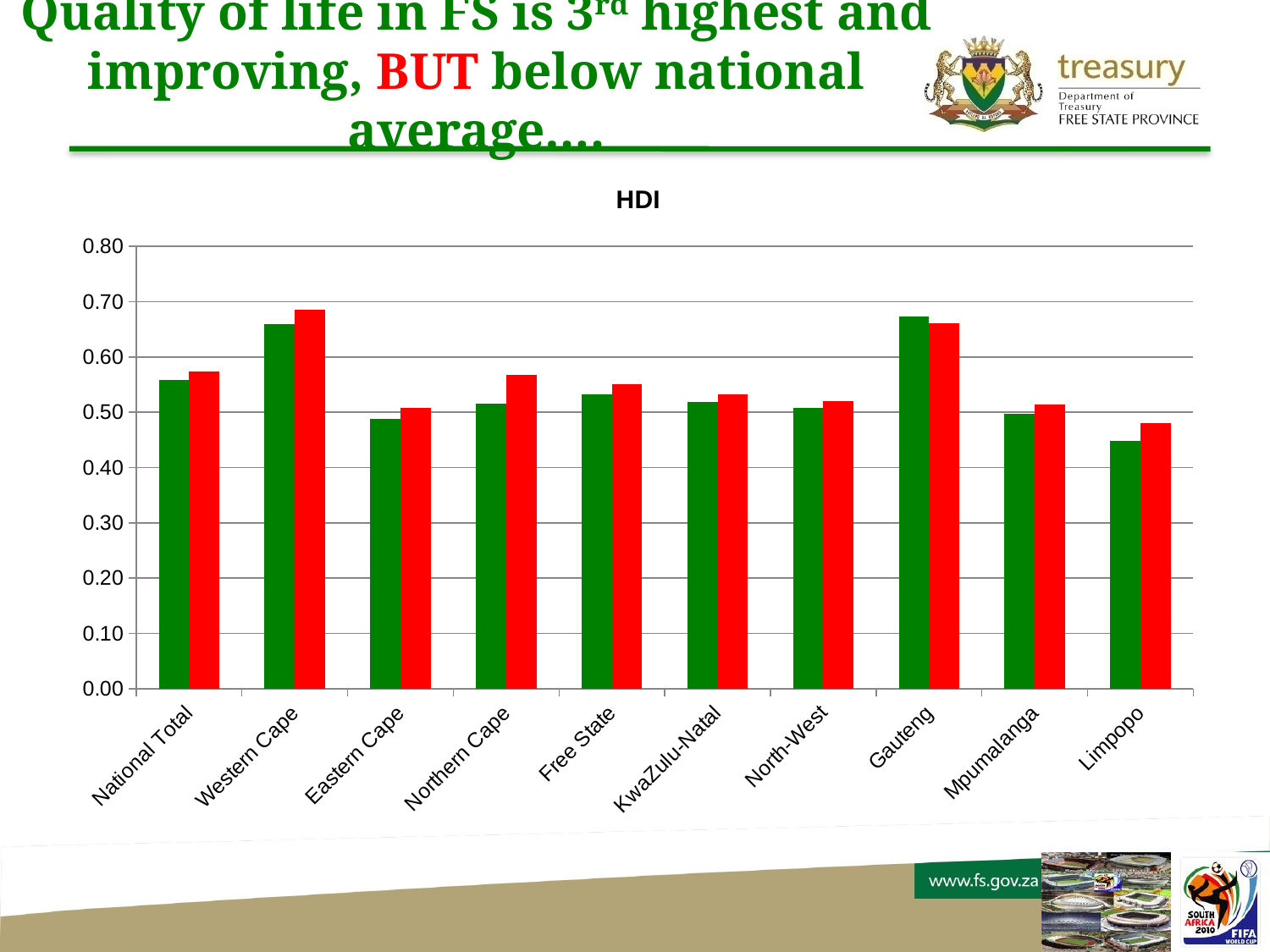
Is the red bar for Western Cape greater or less than 0.60? greater What is the title of the chart? HDI Which category has the lowest bars in the HDI chart? Limpopo How many categories are shown on the x axis of the HDI chart? 10 How many bars are plotted for each category in the HDI chart? 2 What kind of chart is shown on the slide? bar chart Is the red bar for Gauteng greater or less than 0.60? greater Which is larger in the HDI chart: the green bar for Gauteng or the green bar for Limpopo? Gauteng Is the green bar for Eastern Cape greater or less than 0.50? less Which category has the tallest red bar in the HDI chart? Western Cape Which is larger in the HDI chart: the red bar for Free State or the red bar for National Total? National Total